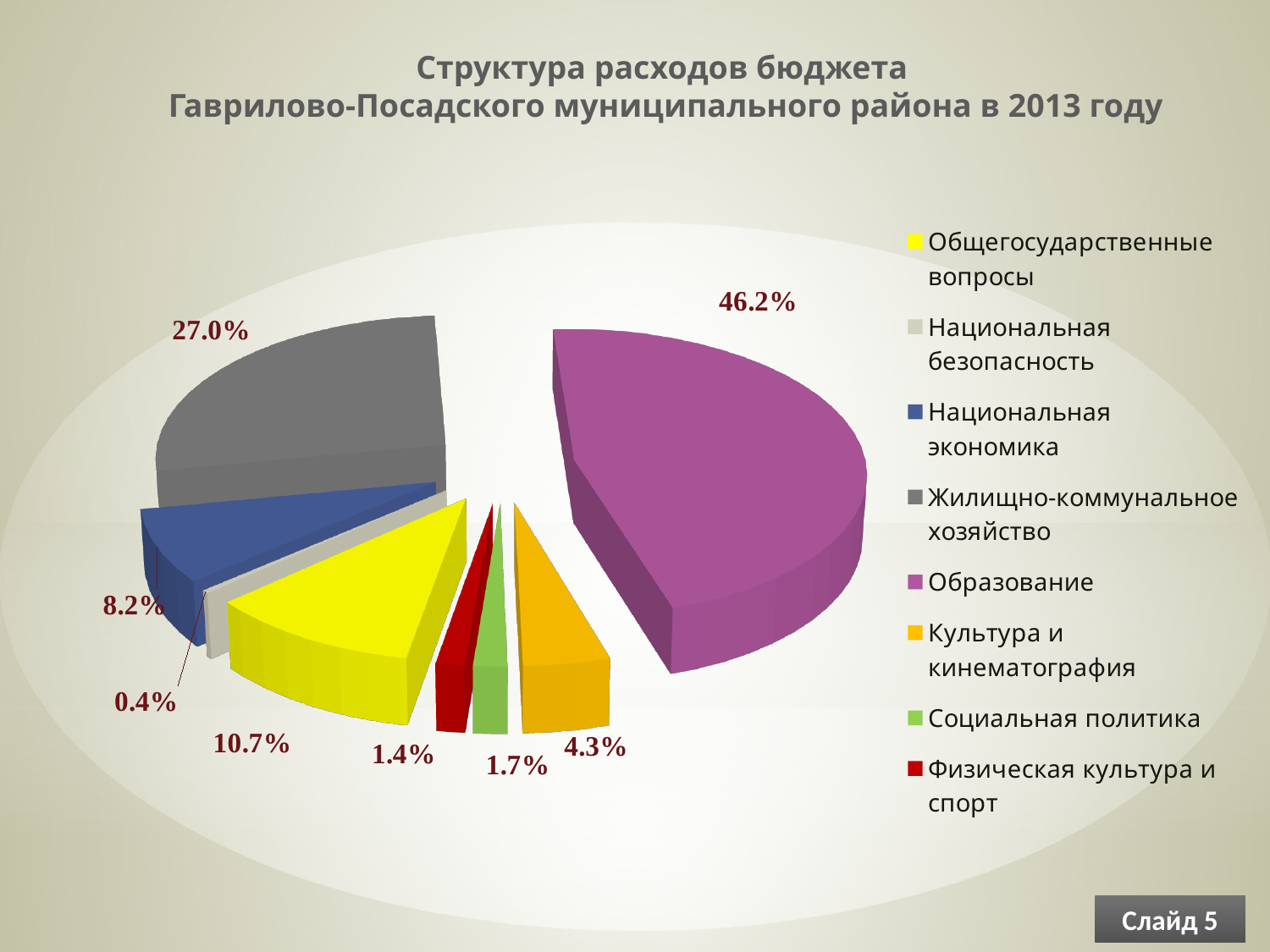
What colour represents Социальная политика in the chart? Green Which has a larger share: Национальная экономика or Культура и кинематография? Национальная экономика What share of the budget expenditure goes to Национальная безопасность? 0.4% What share of the budget expenditure goes to Жилищно-коммунальное хозяйство? 27.0% What share of the budget expenditure goes to Образование? 46.2% Which category has the smallest share of budget expenditure? Национальная безопасность What is the difference in percentage points between Образование and Жилищно-коммунальное хозяйство? 19.2 What share of the budget expenditure goes to Общегосударственные вопросы? 10.7% Which category has the largest share of budget expenditure? Образование How many categories does the pie chart show? 8 What type of chart is shown on the slide? Pie chart What share of the budget expenditure goes to Культура и кинематография? 4.3%